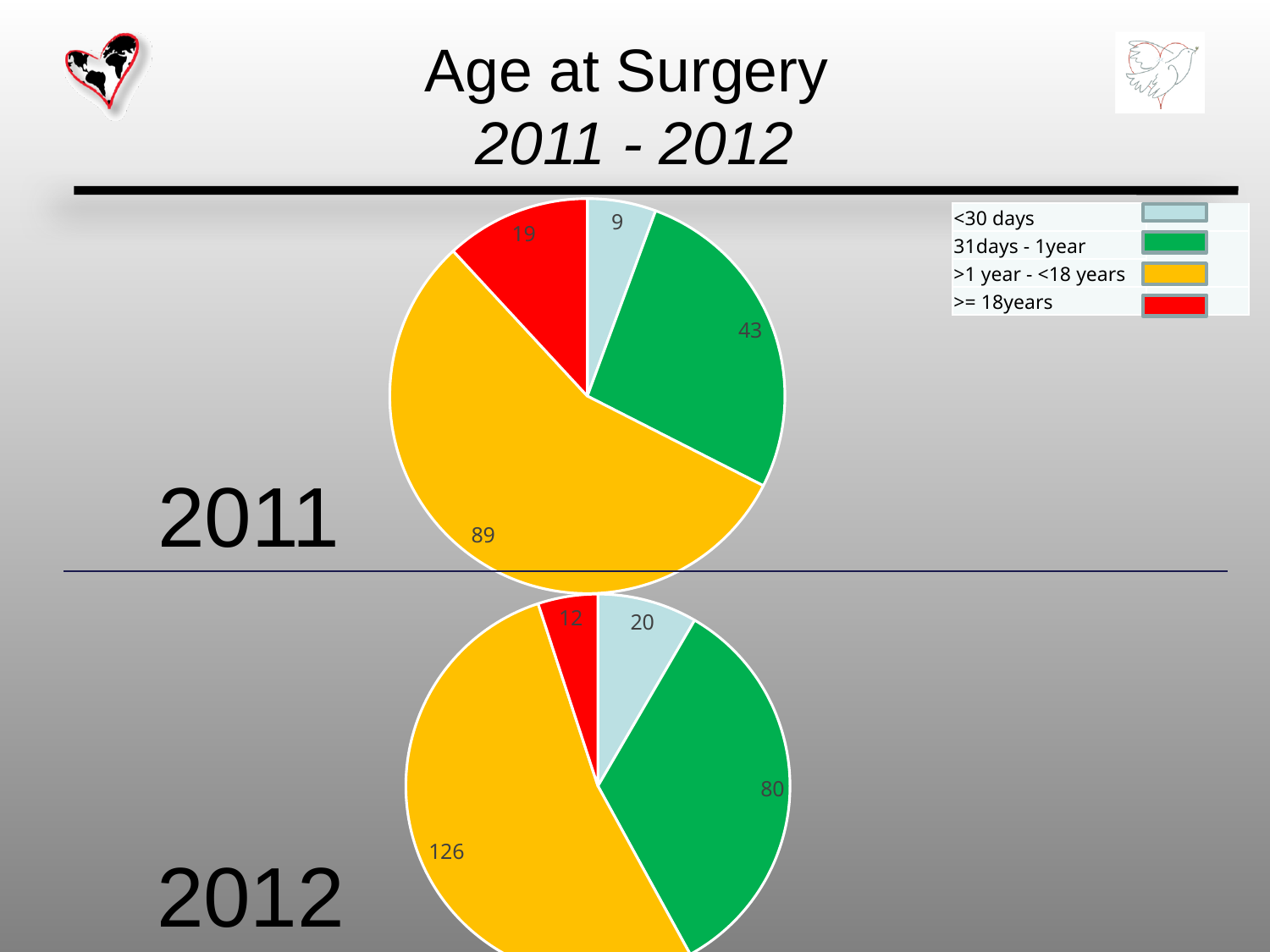
What is the difference between the >1 year - <18 years values in the 2012 and 2011 pie charts? 37 In the 2011 pie chart, what is the value for the >1 year - <18 years category? 89 In the 2011 pie chart, which category has the smallest slice? <30 days In the 2012 pie chart, which category has the largest slice? >1 year - <18 years In the 2011 pie chart, what is the value for the <30 days category? 9 What colour represents the >1 year - <18 years category in the legend? Yellow What type of chart is used to show age at surgery for 2011 and 2012? Pie chart In the 2011 pie chart, which is larger: the 31days - 1year slice or the >= 18years slice? 31days - 1year In the 2012 pie chart, what is the value for the 31days - 1year category? 80 In the 2012 pie chart, what is the value for the >= 18years category? 12 In the 2012 pie chart, which category has the smallest slice? >= 18years How many categories does the legend list for the pie charts? 4